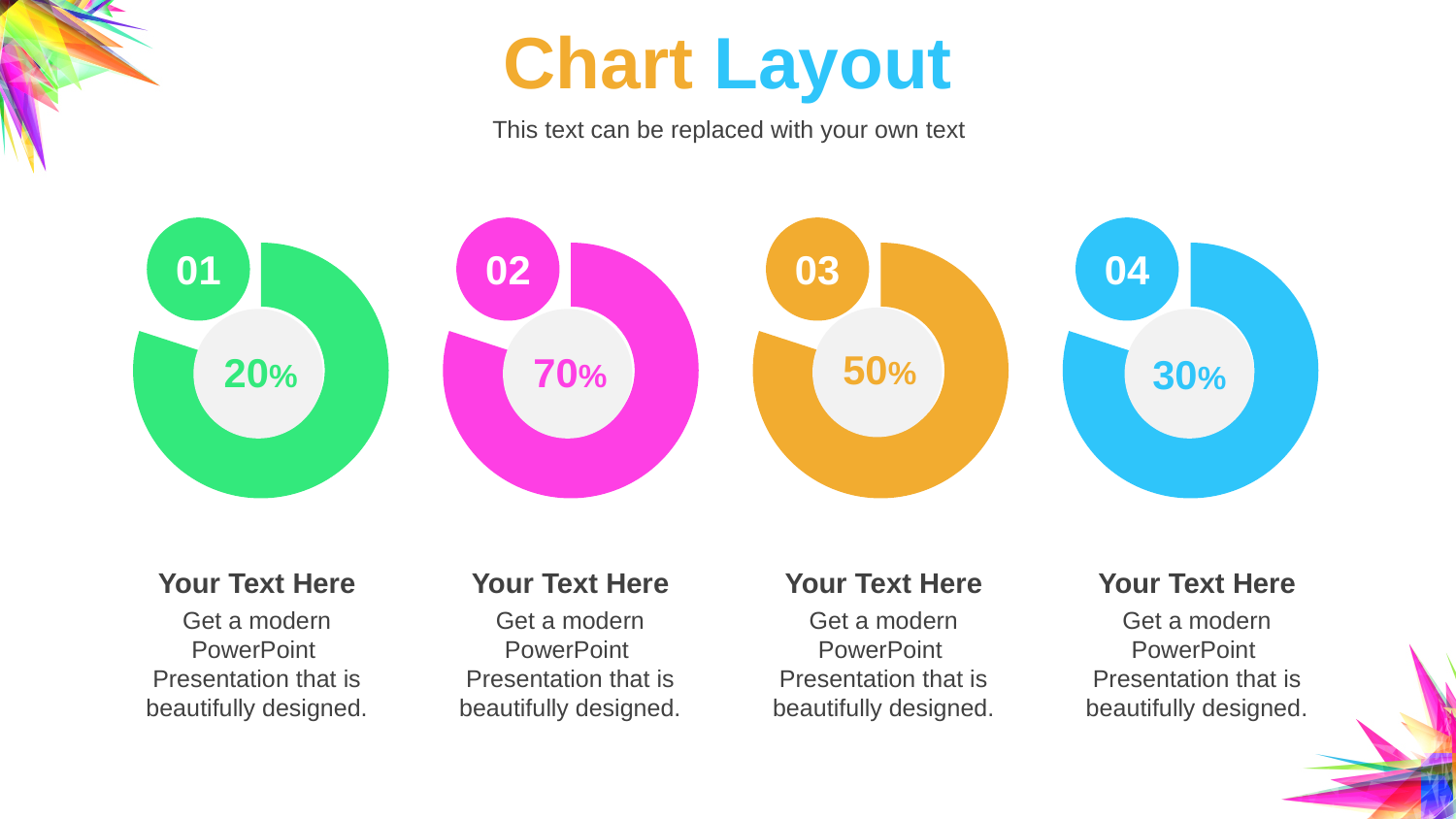
Which of the four charts shows the highest percentage? 02 What percentage is shown in the chart labelled 01? 20% Which shows a larger percentage, chart 03 or chart 04? 03 What percentage is shown in the chart labelled 04? 30% What percentage is shown in the chart labelled 03? 50% What colour is the chart labelled 04? blue What kind of chart is used for each of the four items on the slide? donut chart What is the difference between the percentage in chart 03 and the percentage in chart 04? 20% What is the difference between the percentage in chart 02 and the percentage in chart 01? 50% How many donut charts are shown on the slide? 4 Which of the four charts shows the lowest percentage? 01 What percentage is shown in the chart labelled 02? 70%